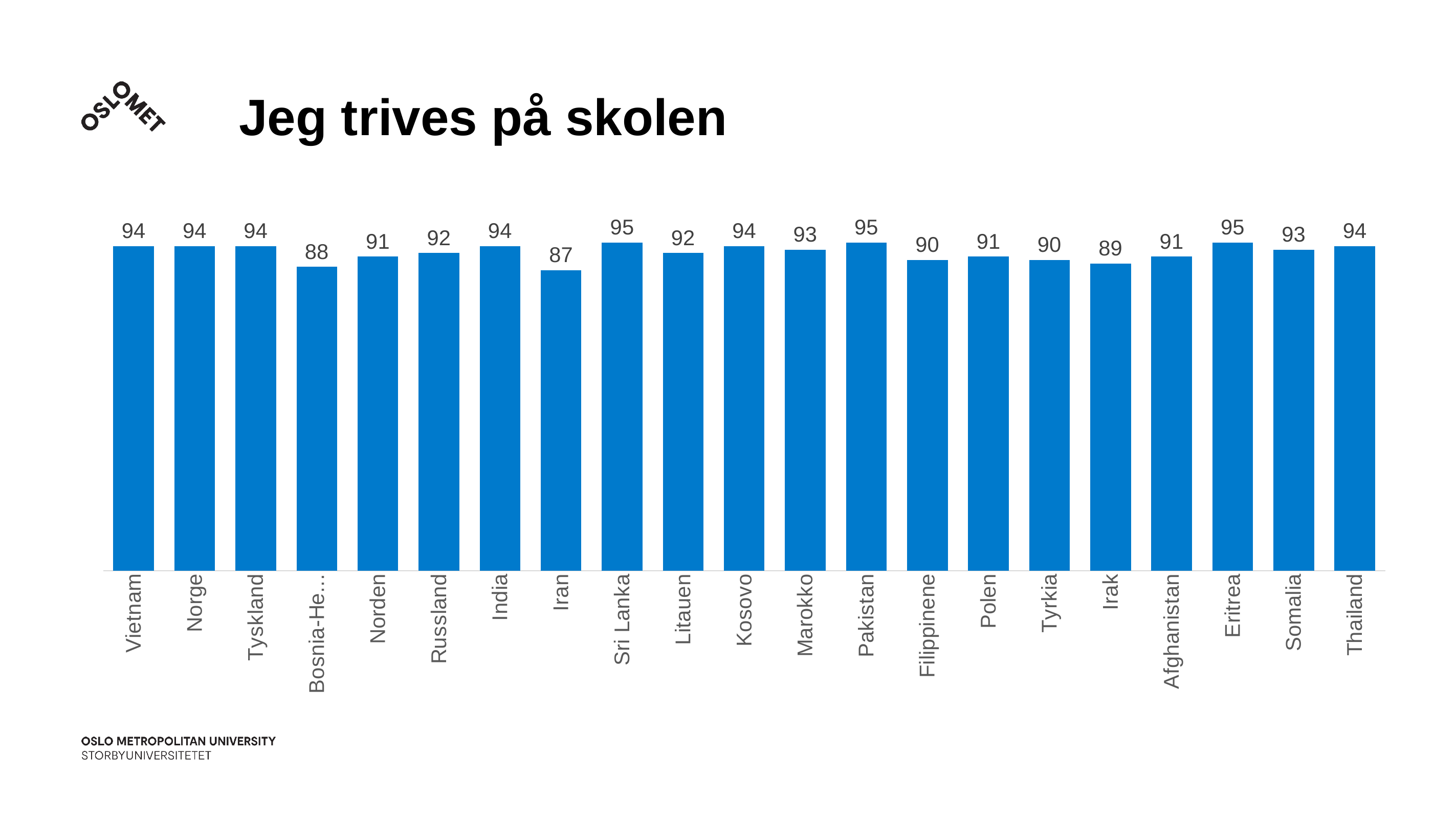
What is the value for Filippinene? 90 What is the value for Sri Lanka? 95 What is the title of the chart? Jeg trives på skolen What is the difference between the values for Pakistan and Irak? 6 How many countries are shown on the chart? 21 Which has a larger value, Bosnia-He... or Marokko? Marokko What is the difference between the values for Vietnam and Iran? 7 Which country has the lowest value? Iran Which has a larger value, Eritrea or Tyrkia? Eritrea What kind of chart is shown on the slide? Bar chart What is the value for Somalia? 93 What is the value for Iran? 87